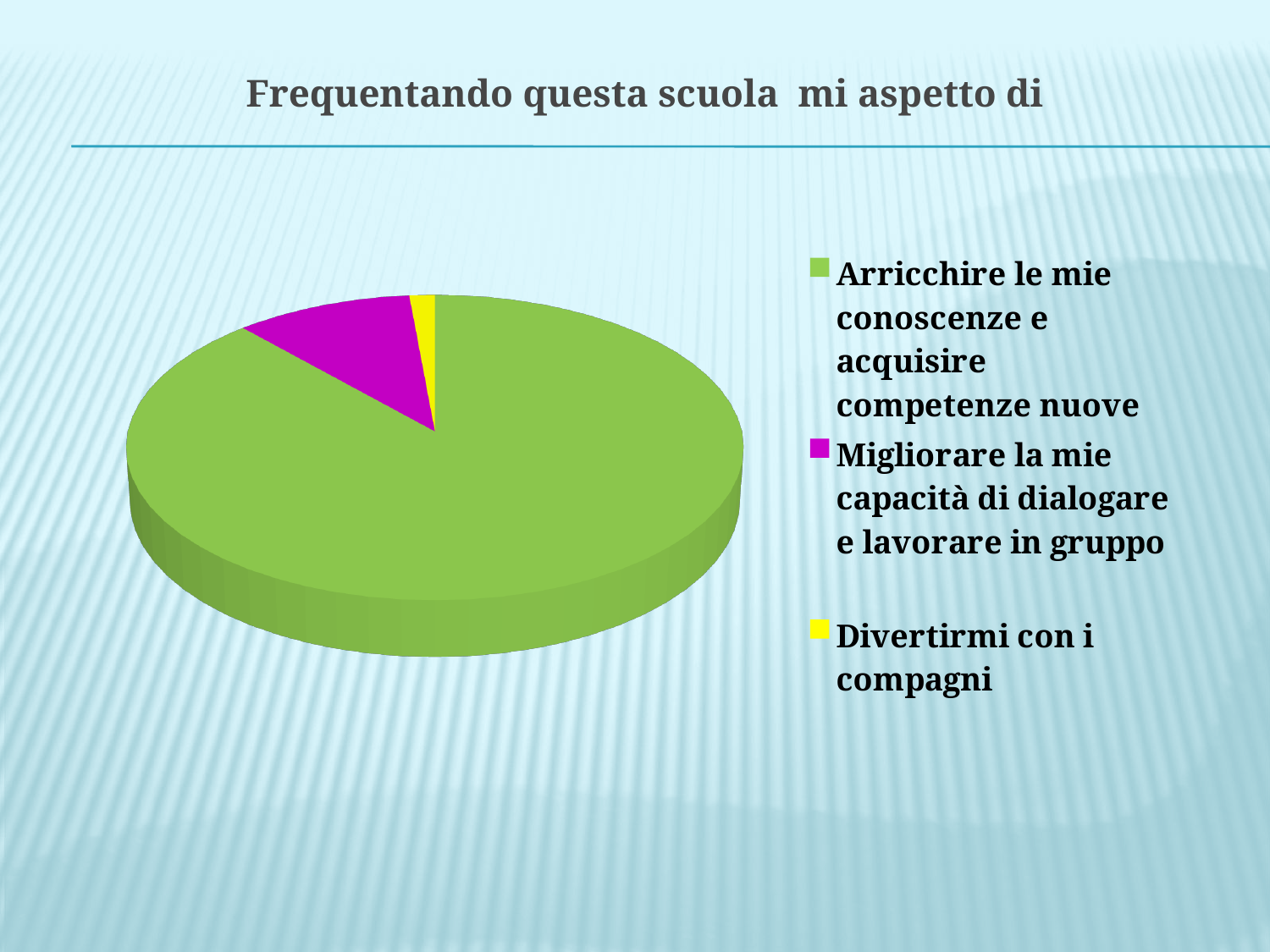
What is the title of the slide containing the pie chart? Frequentando questa scuola mi aspetto di What kind of chart is shown on the slide? pie chart Which slice is larger: "Migliorare la mie capacità di dialogare e lavorare in gruppo" or "Divertirmi con i compagni"? Migliorare la mie capacità di dialogare e lavorare in gruppo What colour is the slice for "Divertirmi con i compagni"? yellow How many entries does the legend list? 3 Which category has the largest slice of the pie? Arricchire le mie conoscenze e acquisire competenze nuove Which category has the smallest slice of the pie? Divertirmi con i compagni Which slice is larger: "Arricchire le mie conoscenze e acquisire competenze nuove" or "Migliorare la mie capacità di dialogare e lavorare in gruppo"? Arricchire le mie conoscenze e acquisire competenze nuove How many slices does the pie chart have? 3